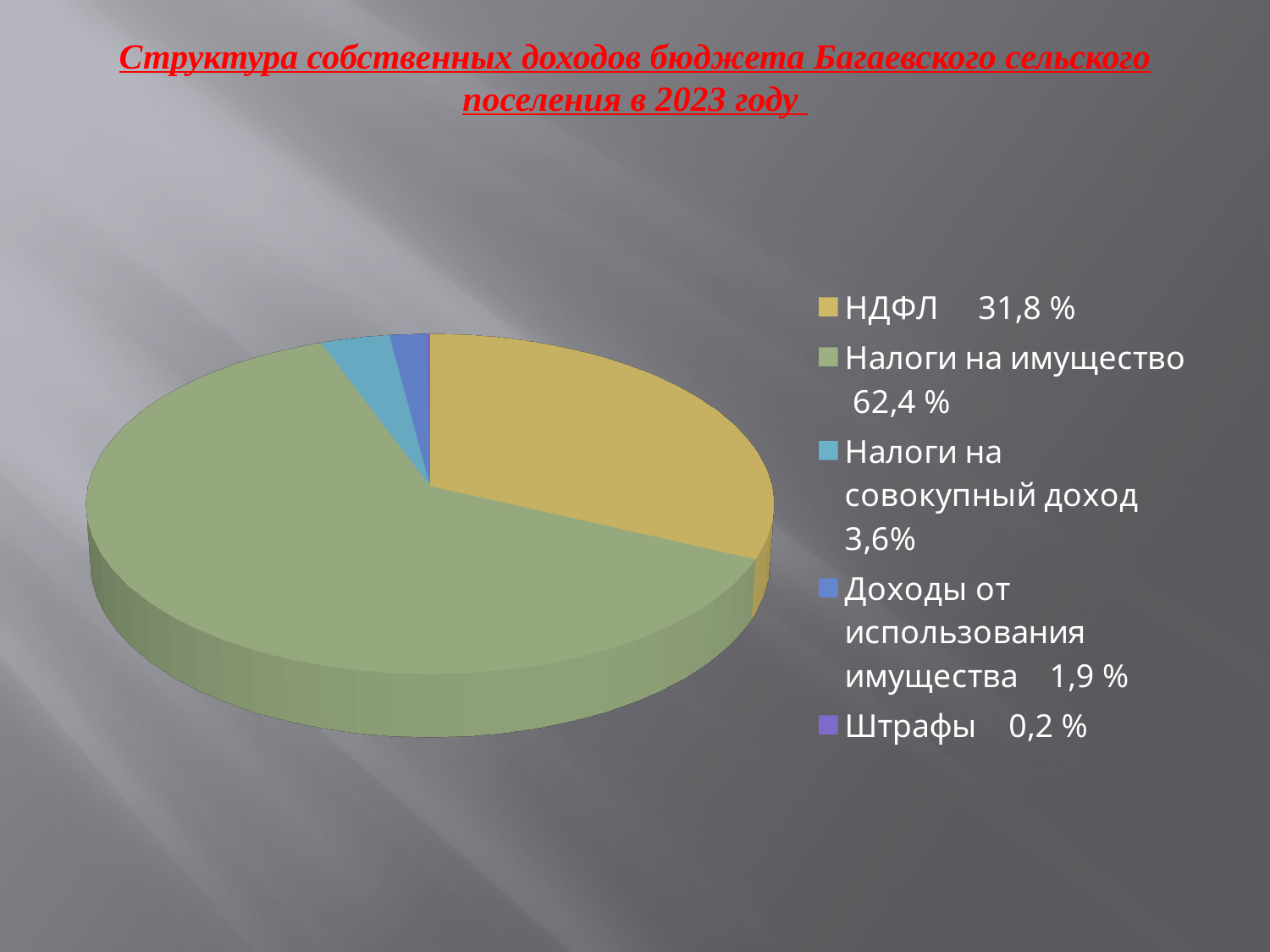
What share of the pie does Налоги на совокупный доход represent? 3,6% What kind of chart is shown on the slide? Pie chart Which is larger, the share for НДФЛ or the share for Налоги на совокупный доход? НДФЛ What share of the pie does Доходы от использования имущества represent? 1,9 % What is the difference in percentage points between Налоги на имущество and НДФЛ? 30,6 How many categories does the pie chart show? 5 Which category has the largest slice of the pie? Налоги на имущество What share of the pie does НДФЛ represent? 31,8 % What colour is the slice for Налоги на имущество? Green What share of the pie does Штрафы represent? 0,2 % Which category has the smallest slice of the pie? Штрафы What share of the pie does Налоги на имущество represent? 62,4 %